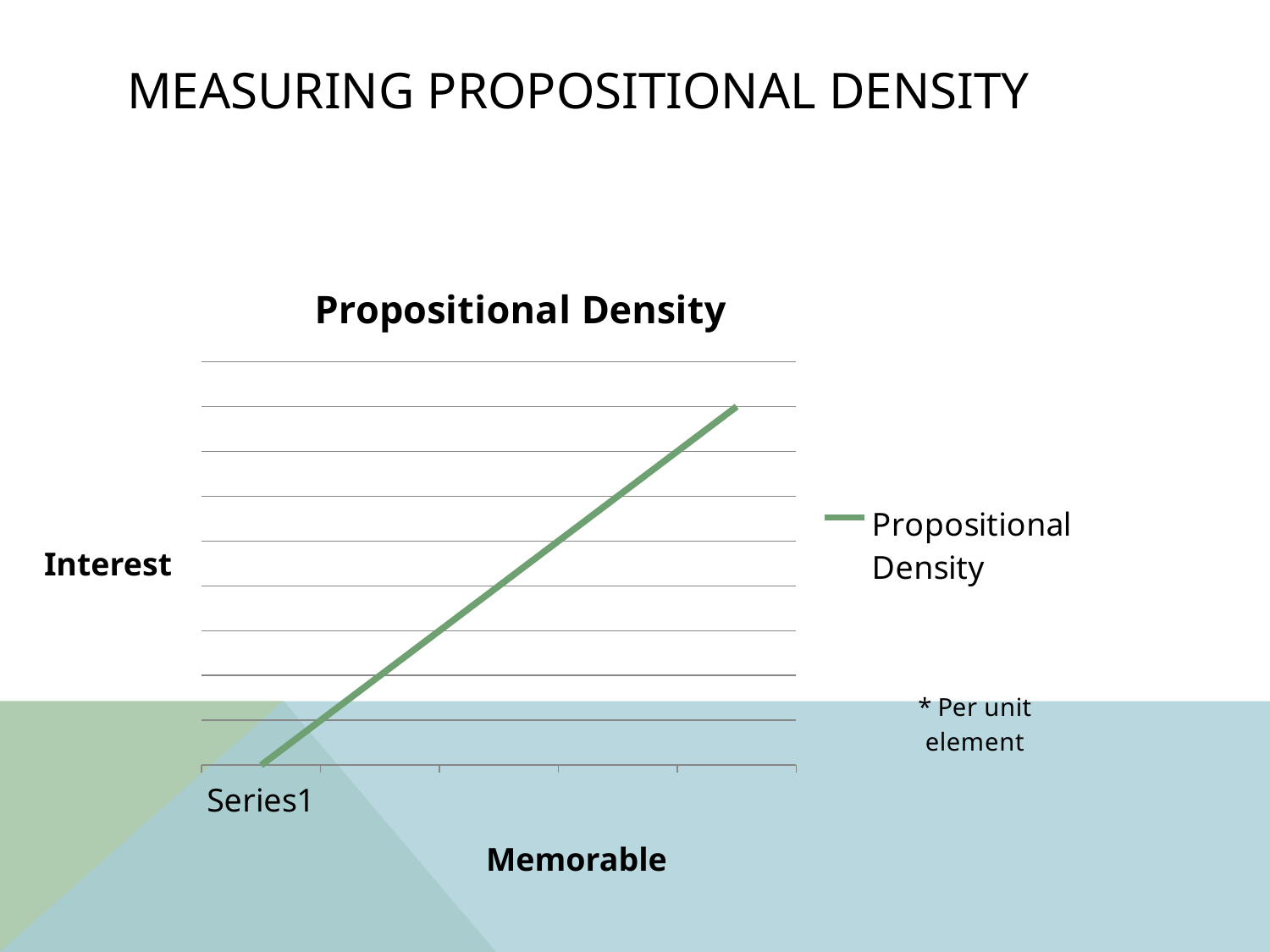
What is the title of the chart? Propositional Density What series name appears in the chart legend? Propositional Density What kind of chart is shown on the slide? Line chart How many series does the legend list? 1 Does the Propositional Density line rise or fall from left to right? Rises